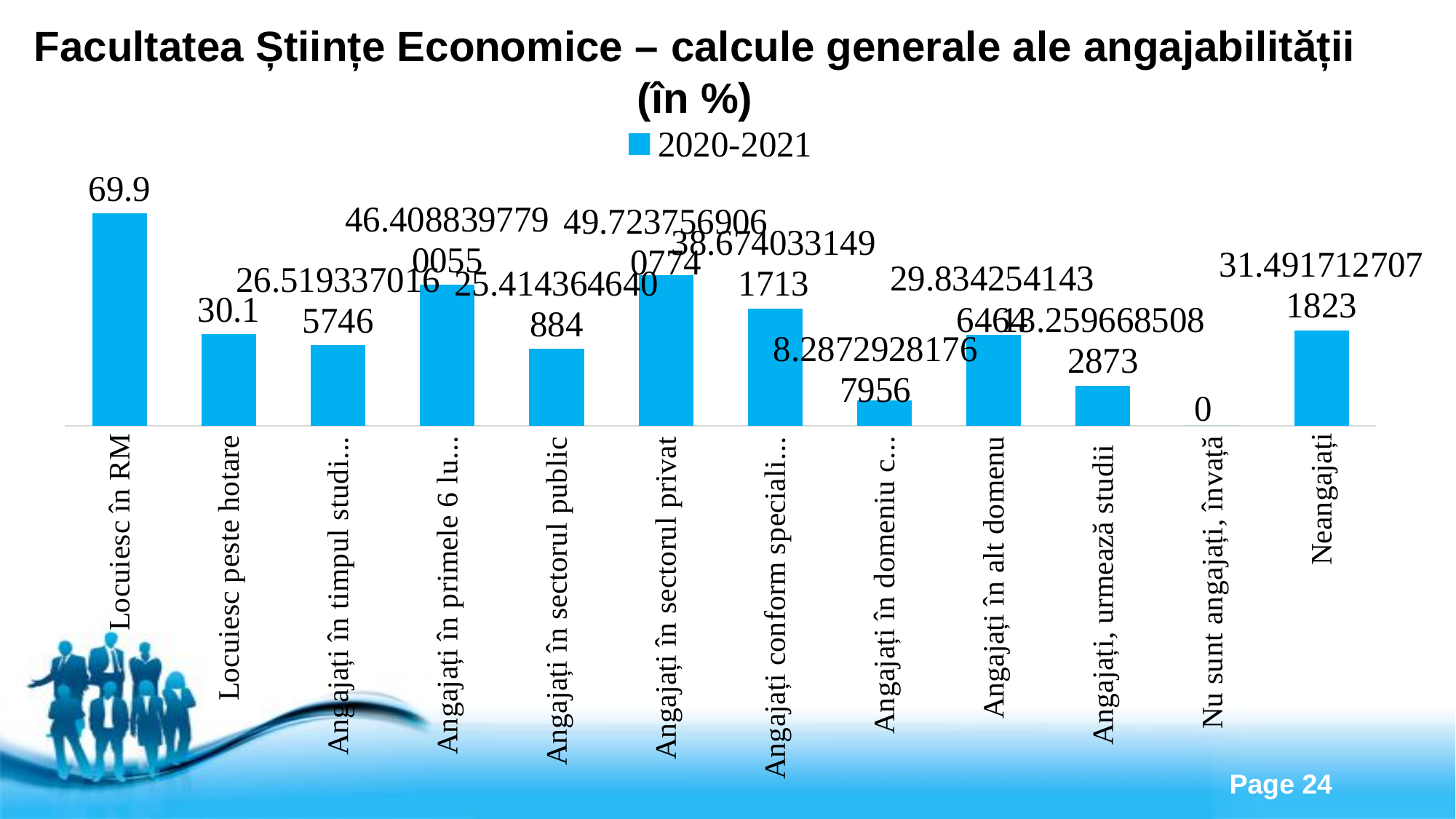
Which is larger: the value for "Angajați în sectorul public" or "Angajați în sectorul privat"? Angajați în sectorul privat How many series does the legend list? 1 What kind of chart is shown on the slide? bar chart What is the legend entry of the chart? 2020-2021 What is the value for "Nu sunt angajați, învață"? 0 How many categories are shown on the x axis? 12 What is the difference between the values for "Locuiesc în RM" and "Locuiesc peste hotare"? 39.8 Which category has the highest value? Locuiesc în RM What is the value for "Neangajați"? 31.4917127071823 Which category has the lowest value? Nu sunt angajați, învață What is the value for "Locuiesc în RM"? 69.9 What is the value for "Locuiesc peste hotare"? 30.1